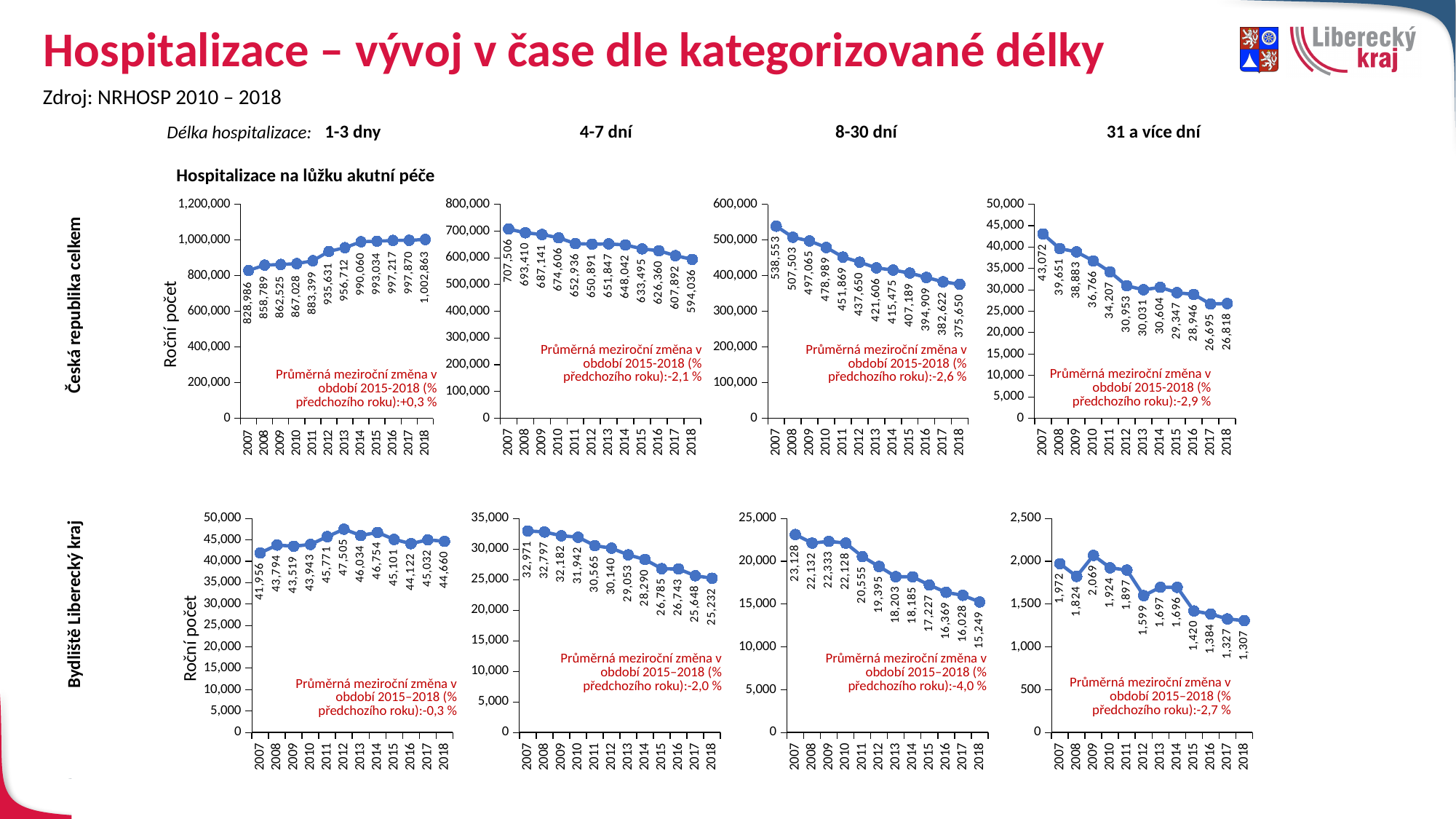
In the top-row chart for 'Česká republika celkem', length '8-30 dní', do the values rise or fall from 2007 to 2018? Fall What is the average year-on-year change stated in red text for the top-row chart 'Česká republika celkem', length '1-3 dny'? +0,3 % In the bottom-row chart for 'Bydliště Liberecký kraj', length '1-3 dny', which year has the highest value? 2012 How many years (data points) are plotted in each chart on the slide? 12 In the top-row chart for 'Česká republika celkem', length '31 a více dní', which is larger: the value for 2007 or the value for 2018? 2007 In the top-row chart for 'Česká republika celkem', length '1-3 dny', what is the value for 2018? 1,002,863 In the bottom-row chart for 'Bydliště Liberecký kraj', length '31 a více dní', what is the value for 2009? 2,069 What kind of chart is used for the 'Hospitalizace na lůžku akutní péče' data on the slide? Line chart In the bottom-row chart for 'Bydliště Liberecký kraj', length '8-30 dní', what is the difference between the 2007 value and the 2018 value? 7,879 In the top-row chart for 'Česká republika celkem', length '8-30 dní', what is the value for 2007? 538,553 In the top-row chart for 'Česká republika celkem', length '4-7 dní', what is the difference between the 2007 value and the 2018 value? 113,470 In the bottom-row chart for 'Bydliště Liberecký kraj', length '31 a více dní', which year has the lowest value? 2018